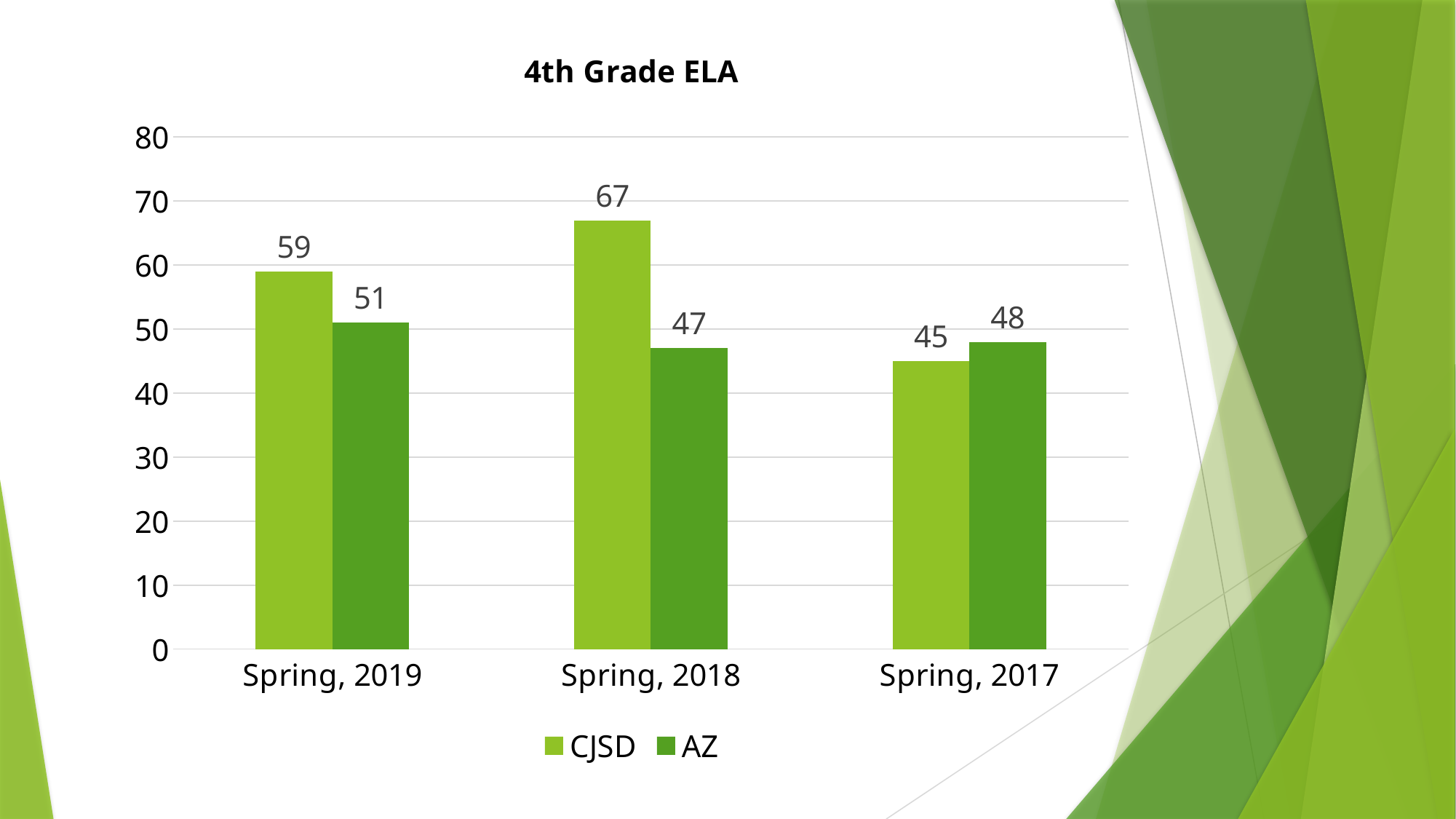
What is the title of the chart? 4th Grade ELA What is the difference between the CJSD and AZ values for Spring, 2018? 20 What is the difference between the CJSD values for Spring, 2019 and Spring, 2017? 14 For Spring, 2017, which series has the larger value, CJSD or AZ? AZ What kind of chart is shown? Bar chart In which period is the CJSD value highest? Spring, 2018 In which period is the CJSD value lowest? Spring, 2017 How many periods are shown on the x axis? 3 What is the CJSD value for Spring, 2019? 59 How many series does the legend list? 2 What is the AZ value for Spring, 2018? 47 What is the AZ value for Spring, 2017? 48